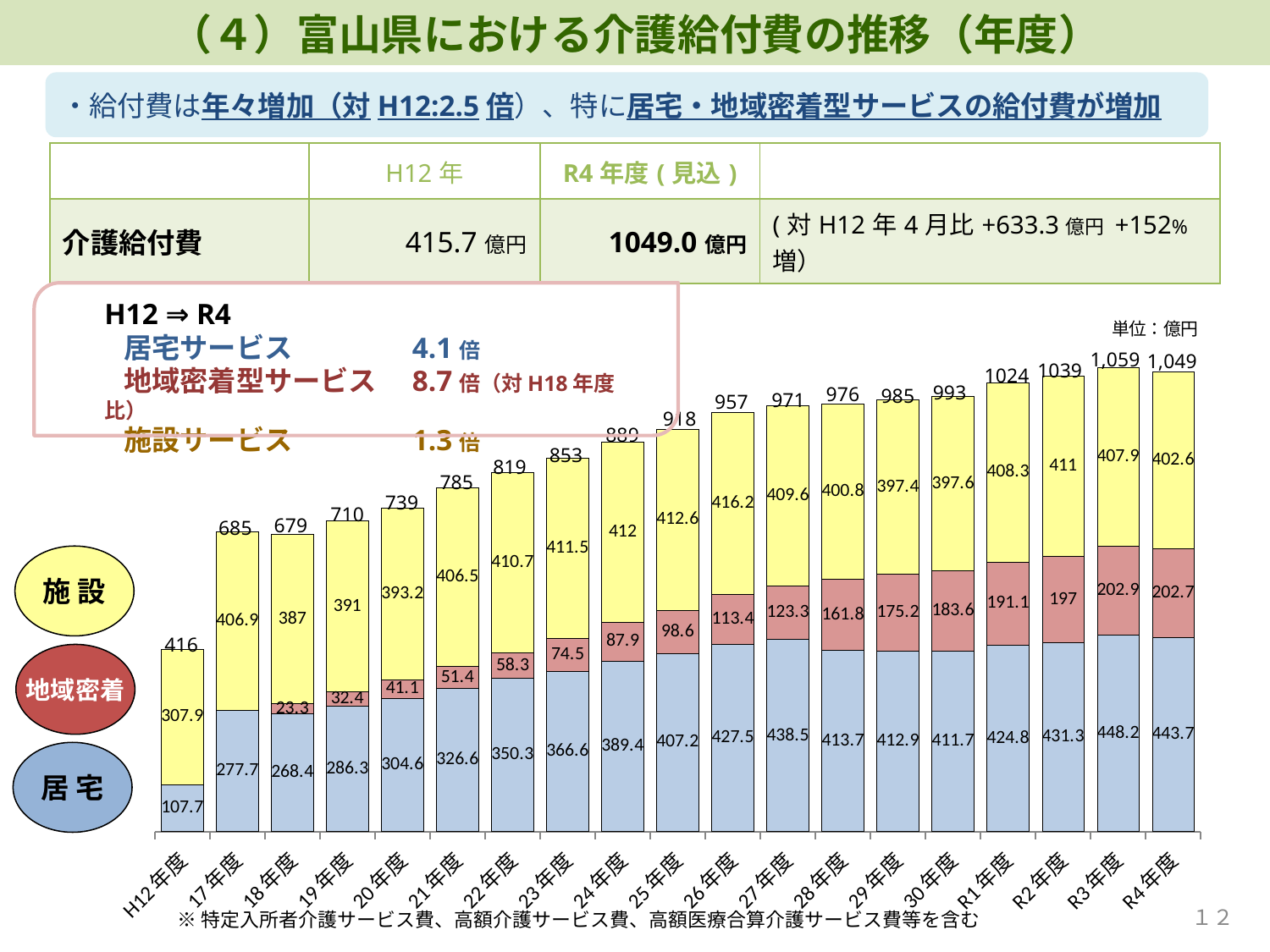
Which is larger for 28年度, the 居宅 value or the 施設 value? 居宅 Which fiscal year has the highest total shown above its bar? R3年度 What is the 地域密着 value for 30年度? 183.6 Do the total values generally rise or fall from H12年度 to R3年度? rise What is the 施設 value for H12年度? 307.9 What is the difference between the 居宅 values for R3年度 and H12年度? 340.5 How many fiscal years are shown on the x axis? 19 How many series does the legend list? 3 What is the total shown for the 26年度 bar? 957 What kind of chart is shown on the slide? stacked bar chart Which fiscal year has the lowest total shown above its bar? H12年度 What is the 居宅 value for 25年度? 407.2